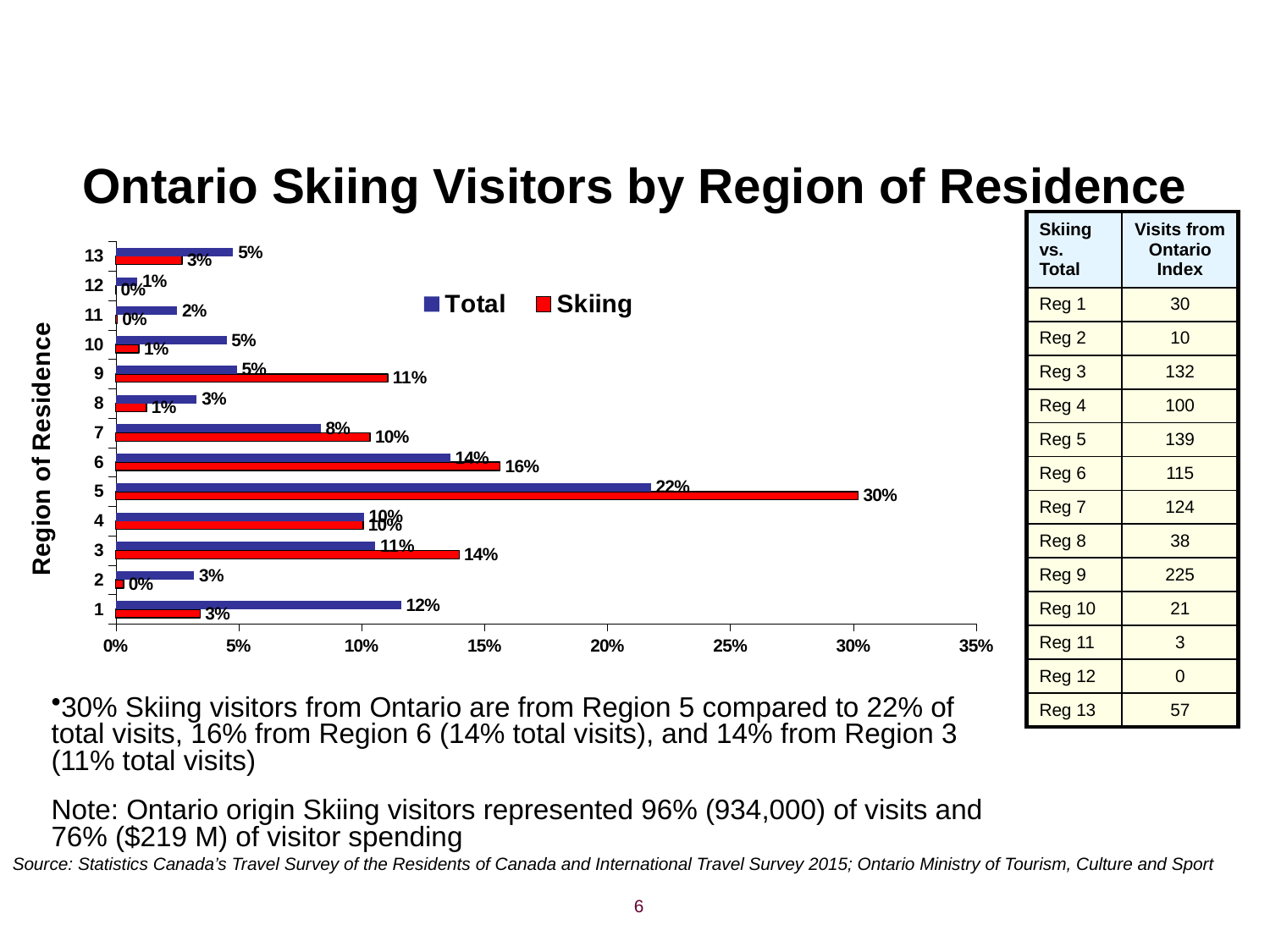
What is the Skiing value for Region 5? 30% What is the Total value for Region 6? 14% What is the Skiing value for Region 9? 11% For Region 9, which is larger, the Total value or the Skiing value? Skiing What type of chart is shown on the slide? Bar chart How many regions are shown on the chart's y axis? 13 What is the difference between the Skiing and Total values for Region 5? 8% Which region has the highest Total value? 5 What is the difference between the Total and Skiing values for Region 1? 9% Which region has the highest Skiing value? 5 How many series does the chart legend list? 2 What is the Total value for Region 1? 12%